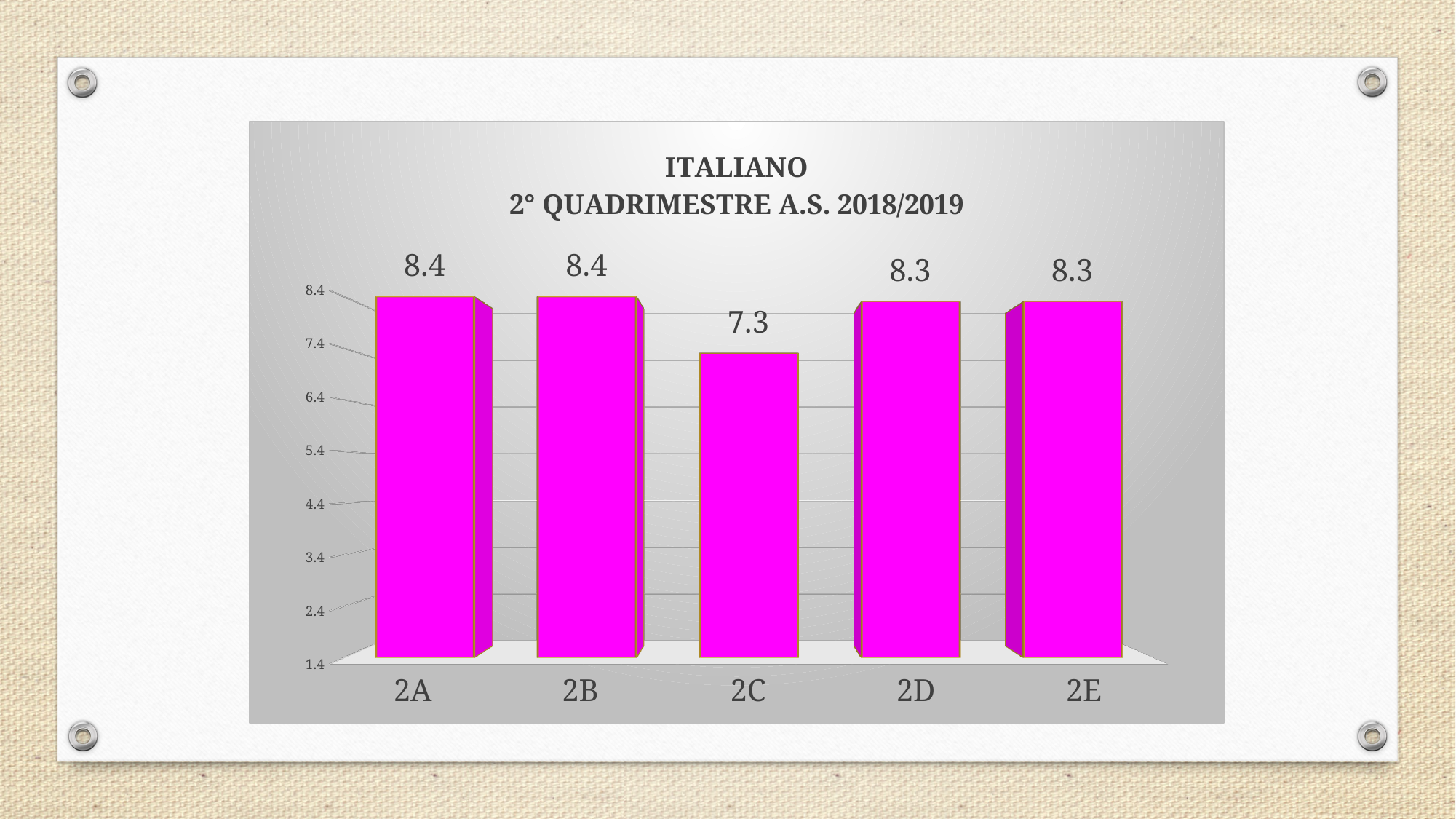
How many categories are shown on the x axis? 5 What is the difference between the values for 2B and 2D? 0.1 What is the value for 2A? 8.4 Which category has the lowest value? 2C What kind of chart is shown on the slide? bar chart What is the value for 2E? 8.3 What is the value for 2D? 8.3 What is the difference between the values for 2A and 2C? 1.1 Is the value for 2C greater or less than 7.4? less Which is larger, the value for 2B or the value for 2C? 2B What is the title of the chart? ITALIANO 2° QUADRIMESTRE A.S. 2018/2019 What is the value for 2C? 7.3